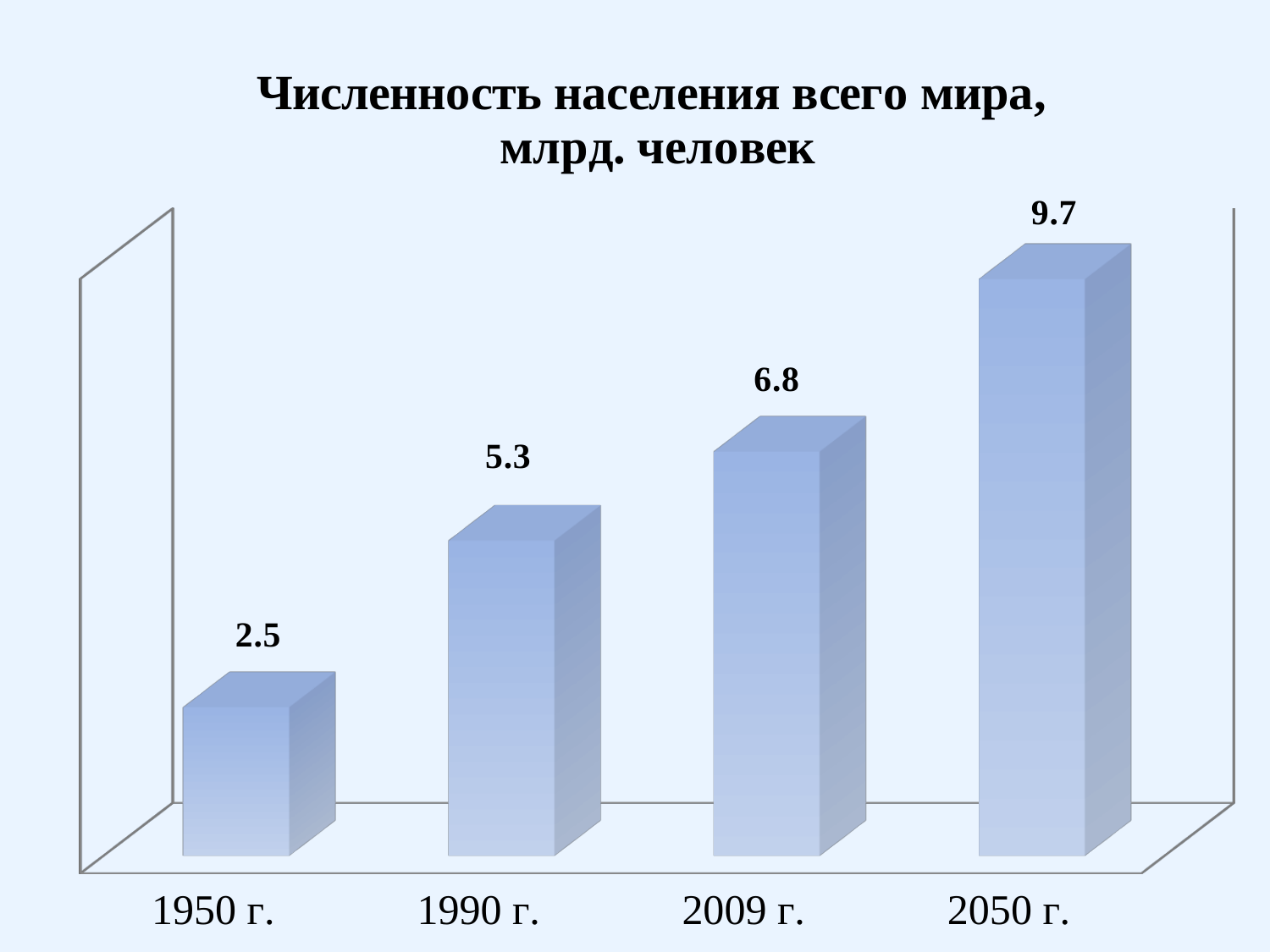
Which is larger, the value for 1990 г. or the value for 2009 г.? 2009 г. What kind of chart is this? bar chart What is the difference between the values for 2050 г. and 1950 г.? 7.2 What is the value for 2050 г.? 9.7 What is the value for 2009 г.? 6.8 How many categories are shown on the chart? 4 What is the value for 1990 г.? 5.3 Which year has the highest value? 2050 г. Do the values rise or fall from 1950 г. to 2050 г.? rise What is the value for 1950 г.? 2.5 Which year has the lowest value? 1950 г. What is the difference between the values for 2009 г. and 1990 г.? 1.5